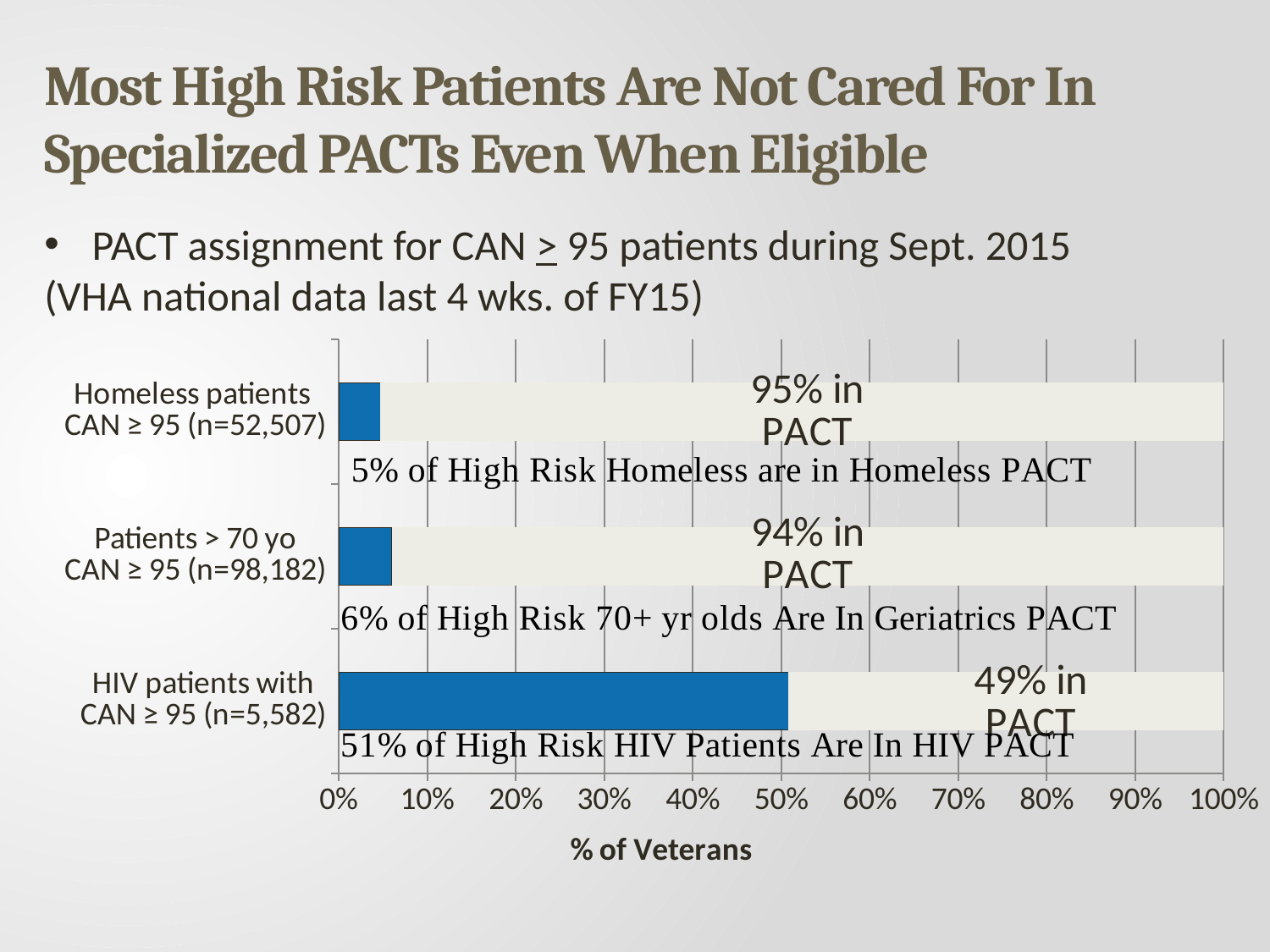
Is the blue bar for Homeless patients CAN ≥ 95 greater or less than 10%? less How many patient groups are shown on the chart? 3 What percentage of high risk homeless patients are in Homeless PACT? 5% What percentage of high risk HIV patients are in HIV PACT? 51% What percentage of homeless patients with CAN ≥ 95 are in PACT (general)? 95% What percentage of HIV patients with CAN ≥ 95 are in PACT (general)? 49% What is the title of the horizontal axis of the chart? % of Veterans What kind of chart is shown on the slide? Bar chart What percentage of high risk 70+ year olds are in Geriatrics PACT? 6% Which patient group has the highest share in its specialized PACT? HIV patients with CAN ≥ 95 How many percentage points higher is the share of high risk HIV patients in HIV PACT than the share of high risk 70+ year olds in Geriatrics PACT? 45 percentage points Which patient group has the lowest share in its specialized PACT? Homeless patients CAN ≥ 95